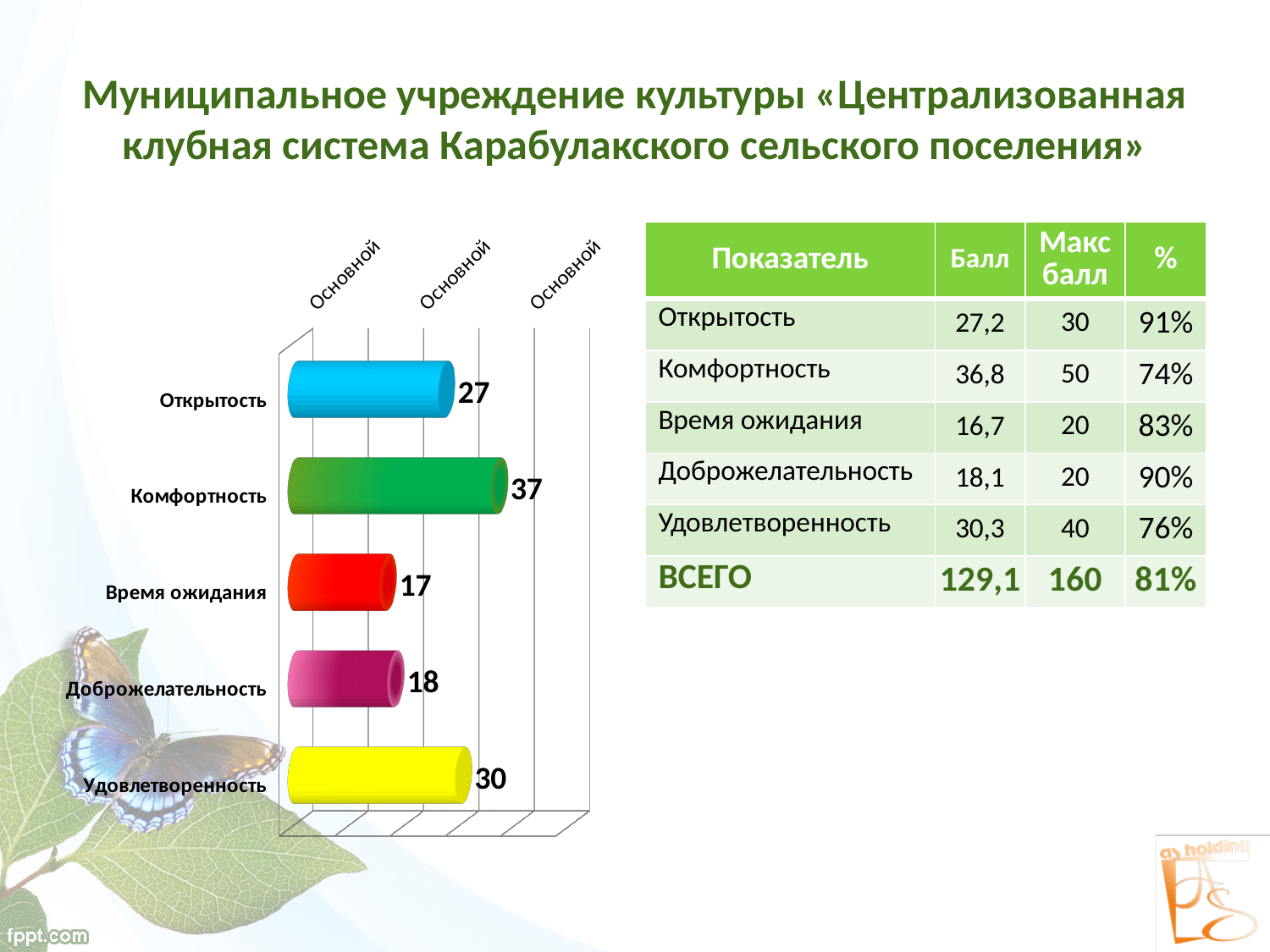
Which is larger, the value for Открытость or the value for Удовлетворенность? Удовлетворенность What is the value for Удовлетворенность in the chart? 30 What is the value for Открытость in the chart? 27 Which category has the highest value in the chart? Комфортность What is the value for Время ожидания in the chart? 17 What is the difference between the values for Комфортность and Открытость? 10 How many categories are shown in the chart? 5 What kind of chart is shown on the slide? Bar chart What is the difference between the values for Удовлетворенность and Доброжелательность? 12 Which category has the lowest value in the chart? Время ожидания What is the value for Комфортность in the chart? 37 What is the value for Доброжелательность in the chart? 18